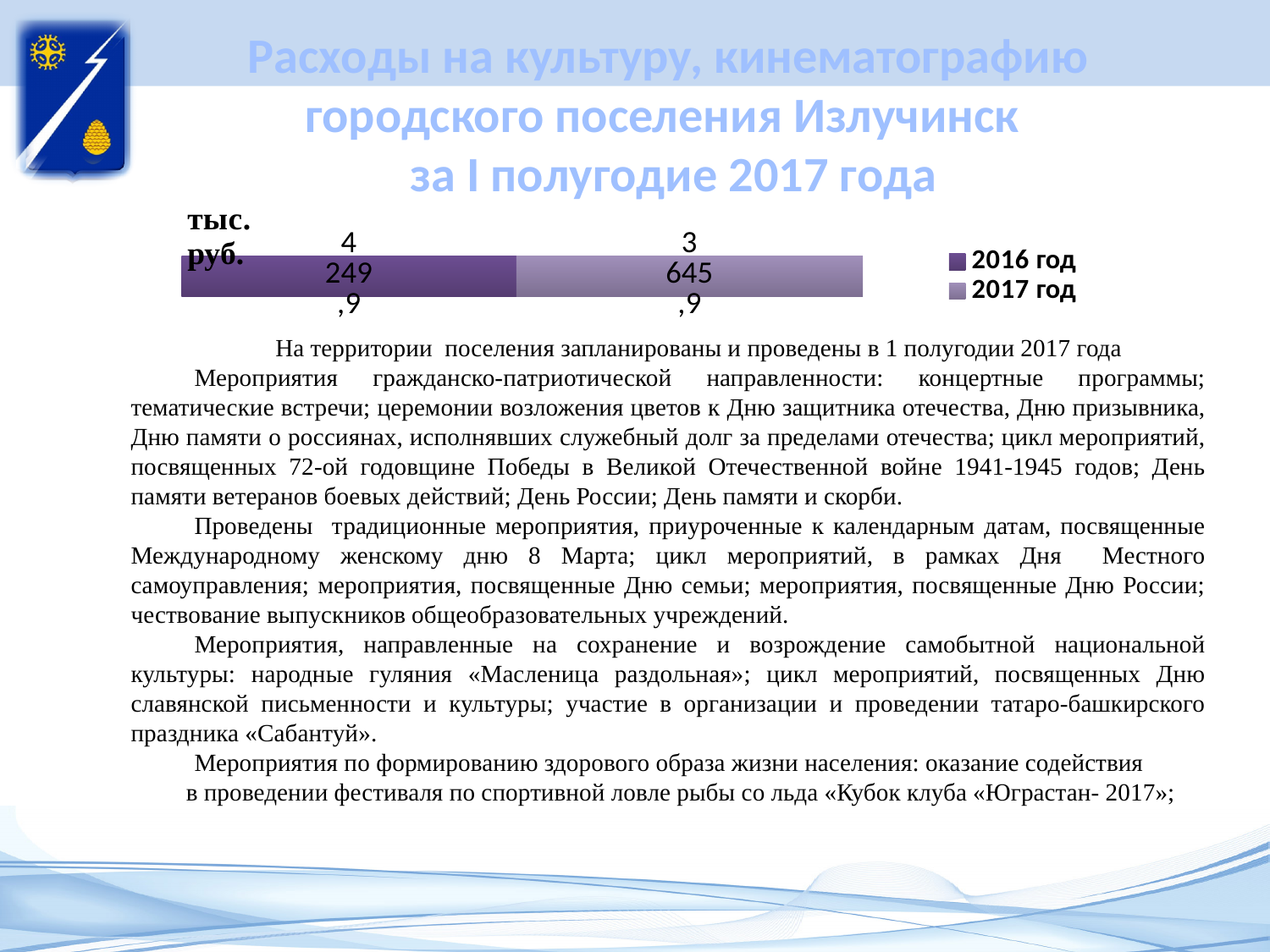
What is the value for 2017 год on the chart? 3 645,9 What unit is shown next to the chart? тыс. руб. Which series has the lowest value on the chart? 2017 год What is the difference between the 2016 год and 2017 год values on the chart? 604 What are the two entries in the chart legend? 2016 год, 2017 год What is the value for 2016 год on the chart? 4 249,9 What is the total of the two segments of the stacked bar on the chart? 7 895,8 How many series does the chart legend list? 2 Did the expenditure fall or rise from 2016 год to 2017 год according to the chart? fall What kind of chart is shown on the slide? bar chart Which series has the highest value on the chart? 2016 год Which year has the larger value on the chart, 2016 год or 2017 год? 2016 год